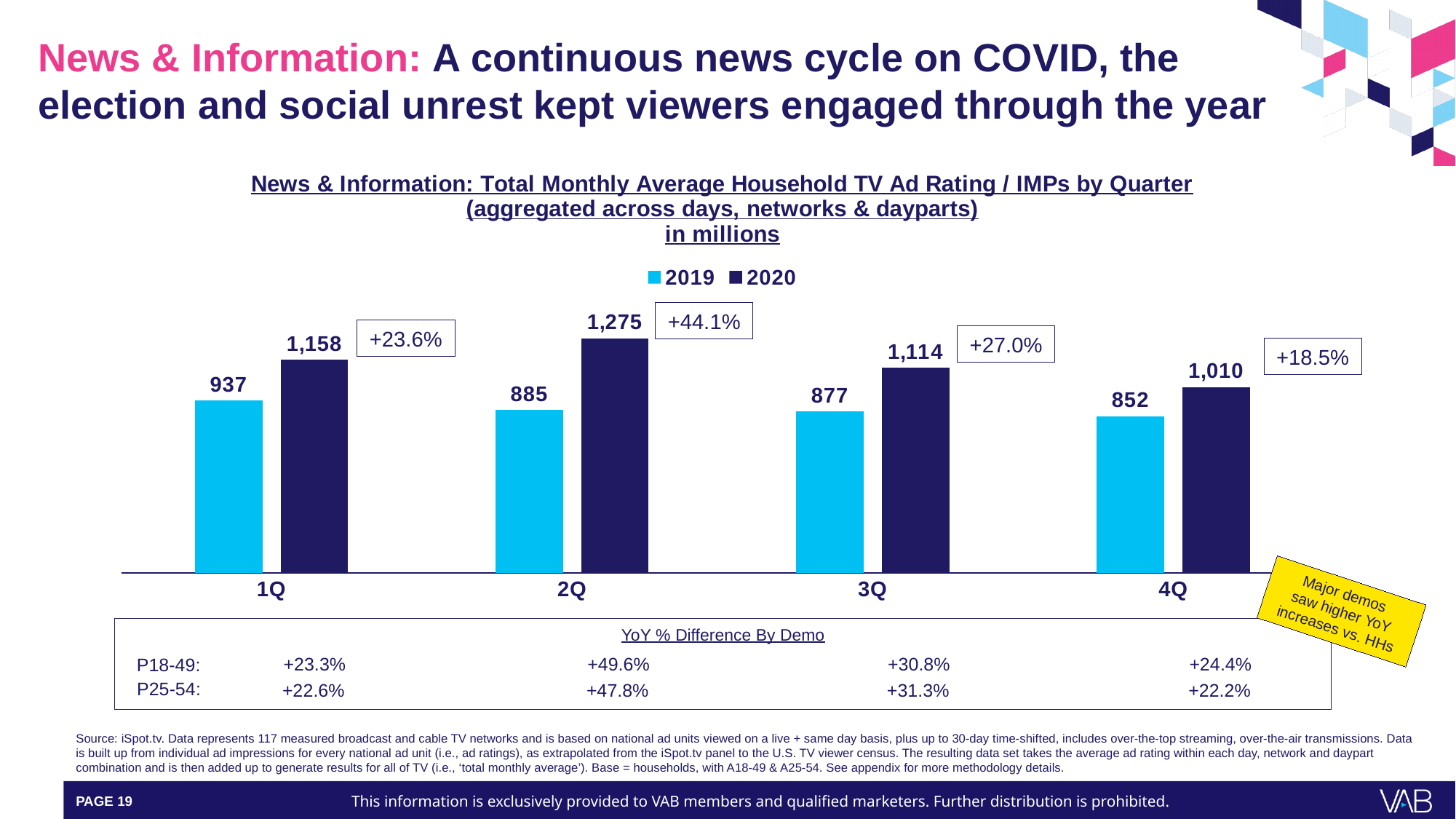
Which colour represents the 2020 series in the legend? Dark navy blue Which quarter has the highest 2020 value? 2Q Which quarter has the lowest 2019 value? 4Q What is the 2020 value for 2Q? 1,275 How many series does the legend list? 2 Which is larger, the 2019 value for 1Q or the 2019 value for 2Q? 2019 value for 1Q How many quarters are shown on the x axis? 4 What is the 2019 value for 4Q? 852 What year-over-year percentage change is shown for 2Q? +44.1% What is the 2019 value for 1Q? 937 What is the difference between the 2020 and 2019 values for 3Q? 237 What kind of chart is shown? Bar chart